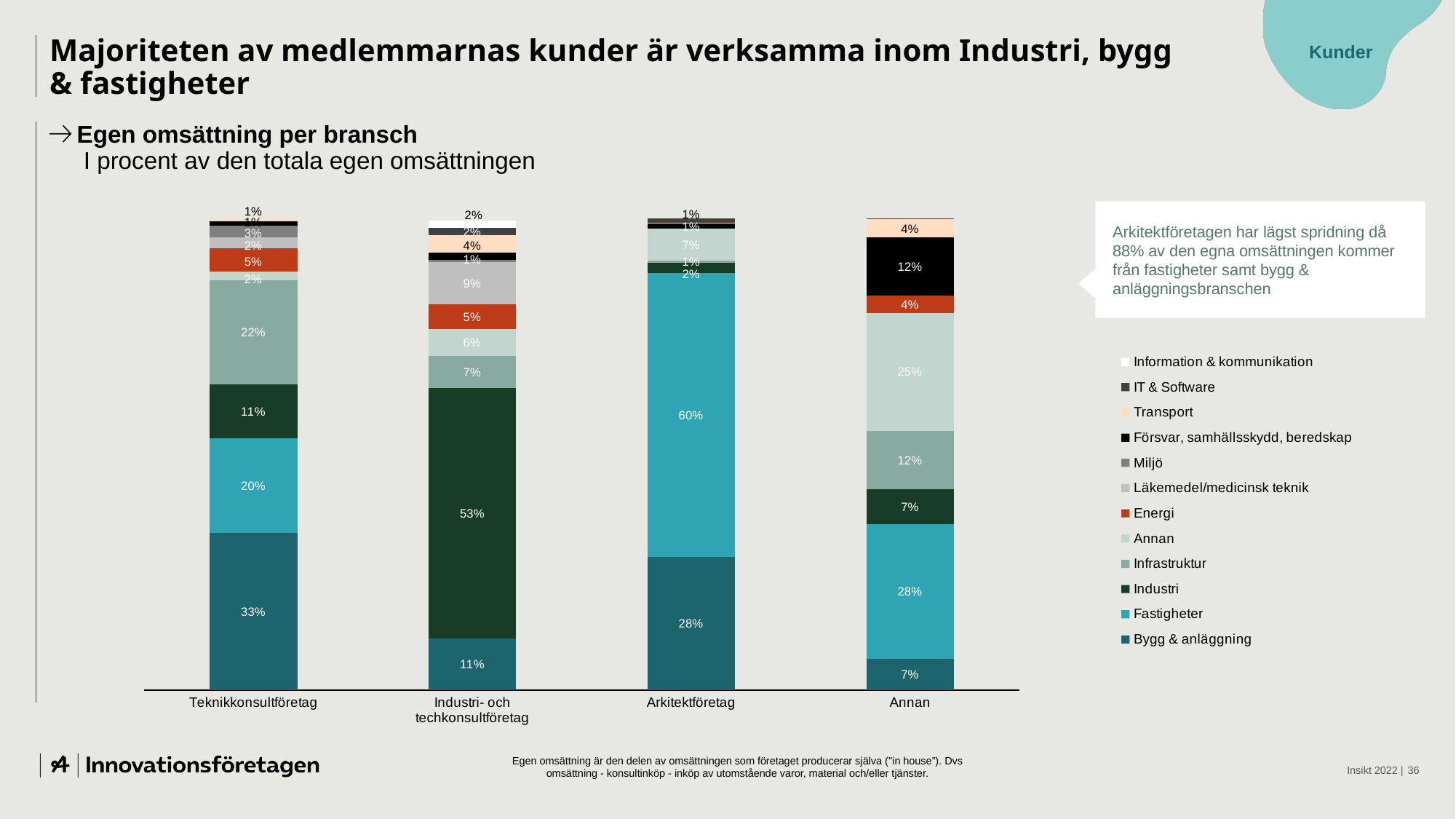
What is the Försvar, samhällsskydd, beredskap share in the Annan bar? 12% What kind of chart is shown on the slide? Stacked bar chart How many series does the chart legend list? 12 What is the Bygg & anläggning share for Teknikkonsultföretag? 33% Which has a larger Bygg & anläggning share: Teknikkonsultföretag or Industri- och techkonsultföretag? Teknikkonsultföretag What share of Arkitektföretag's own turnover comes from Fastigheter? 60% What is the title of the chart? Egen omsättning per bransch Which company category has the largest Fastigheter segment? Arkitektföretag How many company categories are shown along the x axis of the chart? 4 What is the difference in percentage points between the Bygg & anläggning share for Teknikkonsultföretag and for Arkitektföretag? 5 percentage points What is the Industri share for Industri- och techkonsultföretag? 53% What is the Infrastruktur share for Teknikkonsultföretag? 22%